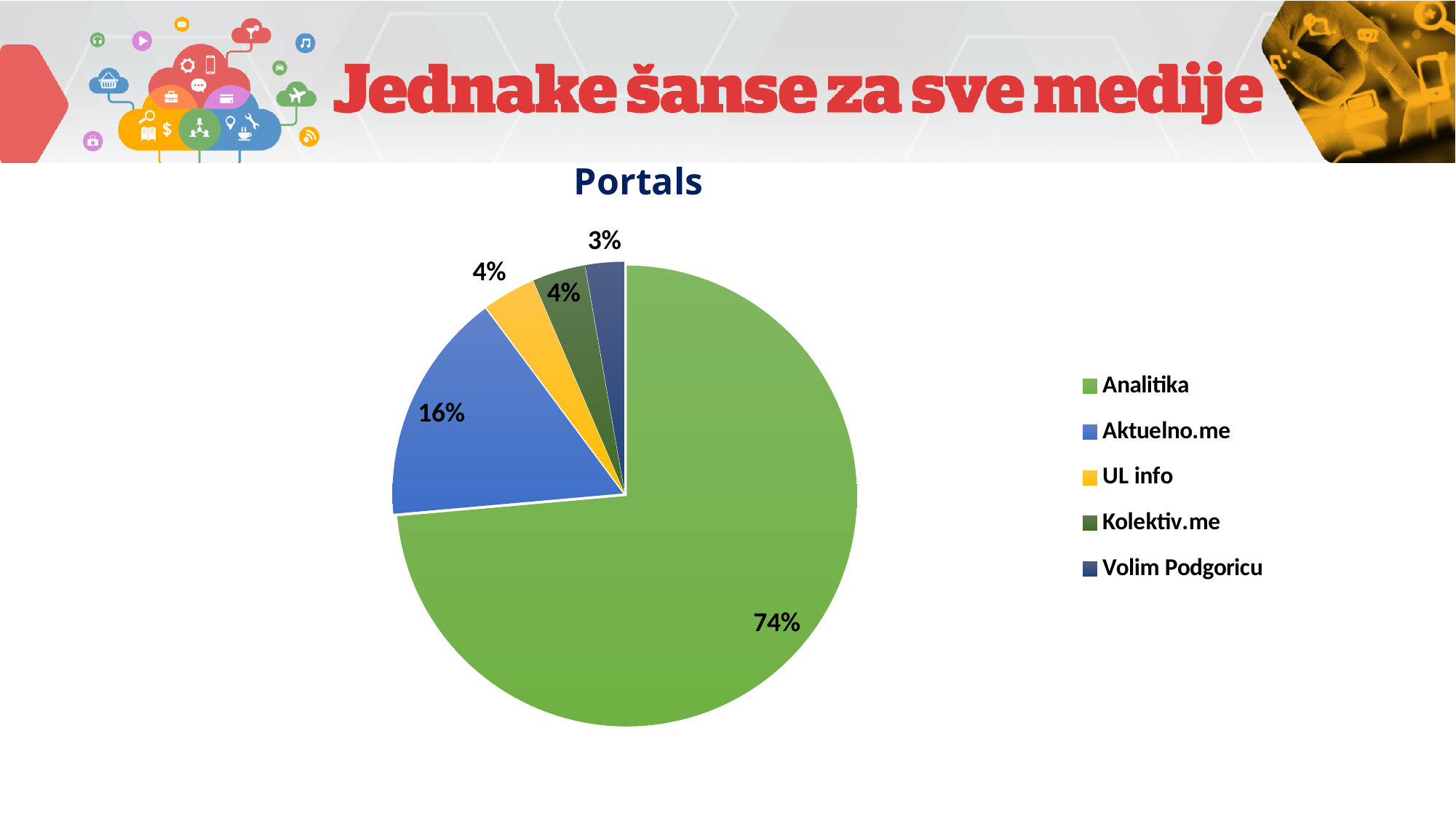
Which portal has the smallest slice of the pie? Volim Podgoricu What colour is the slice for UL info? yellow What share of the pie does UL info have? 4% What share of the pie does Analitika have? 74% What share of the pie does Aktuelno.me have? 16% What type of chart is shown on the slide? pie chart What is the title of the chart? Portals Which has a larger share, Aktuelno.me or Kolektiv.me? Aktuelno.me How many portals are shown in the pie chart? 5 What is the difference in percentage points between Analitika and Aktuelno.me? 58 Which portal has the largest slice of the pie? Analitika